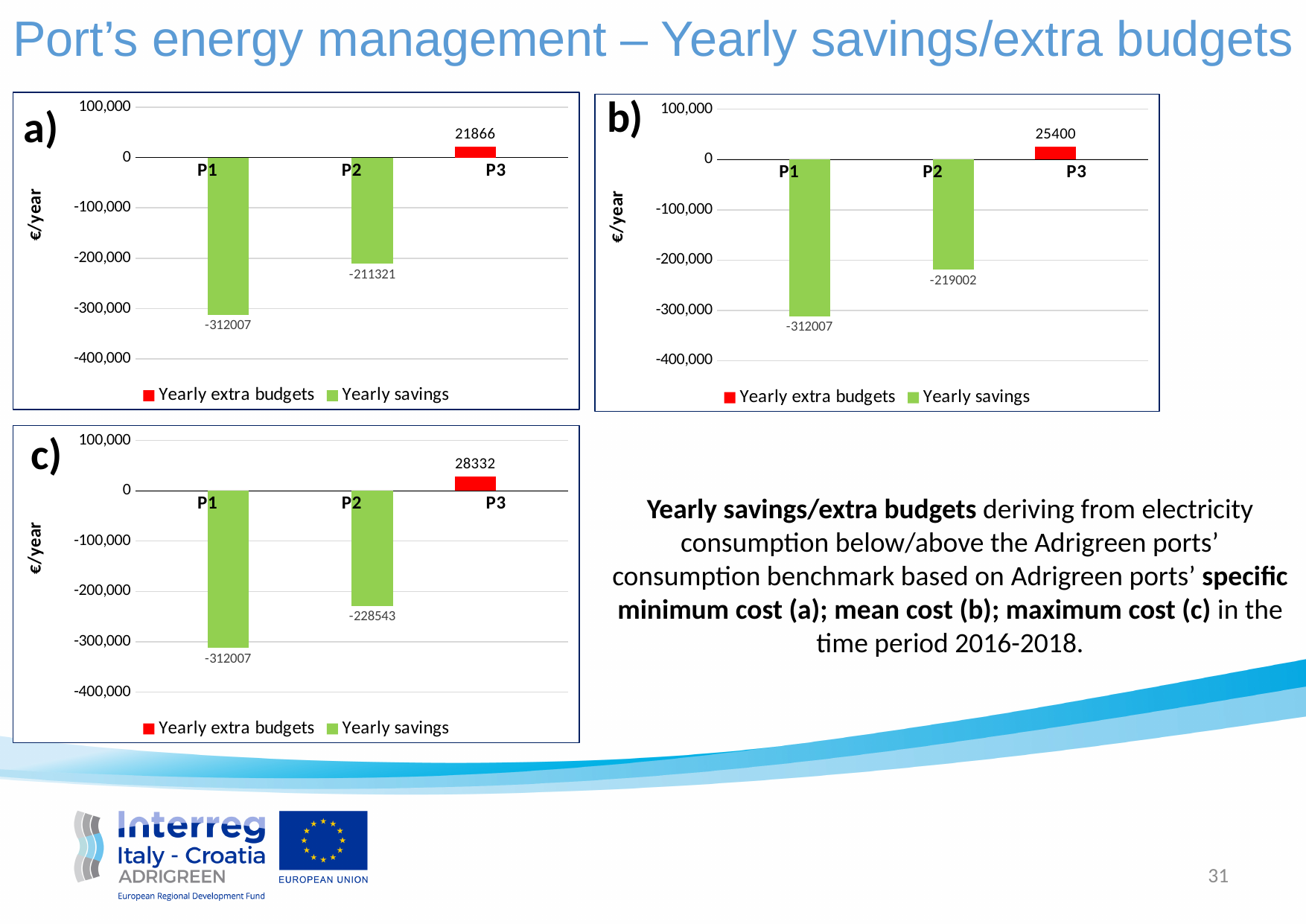
In chart b), what is the value for P2? -219002 In chart b), what is the value for P3? 25400 In chart a), what is the value for P1? -312007 What kind of chart is chart b)? Bar chart In chart c), what is the value for P3? 28332 How many series does the legend of chart c) list? 2 How many ports are shown on the x axis of chart a)? 3 In chart b), which is larger, the value for P2 or the value for P3? P3 In chart c), what is the difference between the values for P2 and P1? 83464 In chart a), which port has the lowest value? P1 In chart c), which port has the highest value? P3 In chart a), what is the difference between the values for P1 and P2? 100686